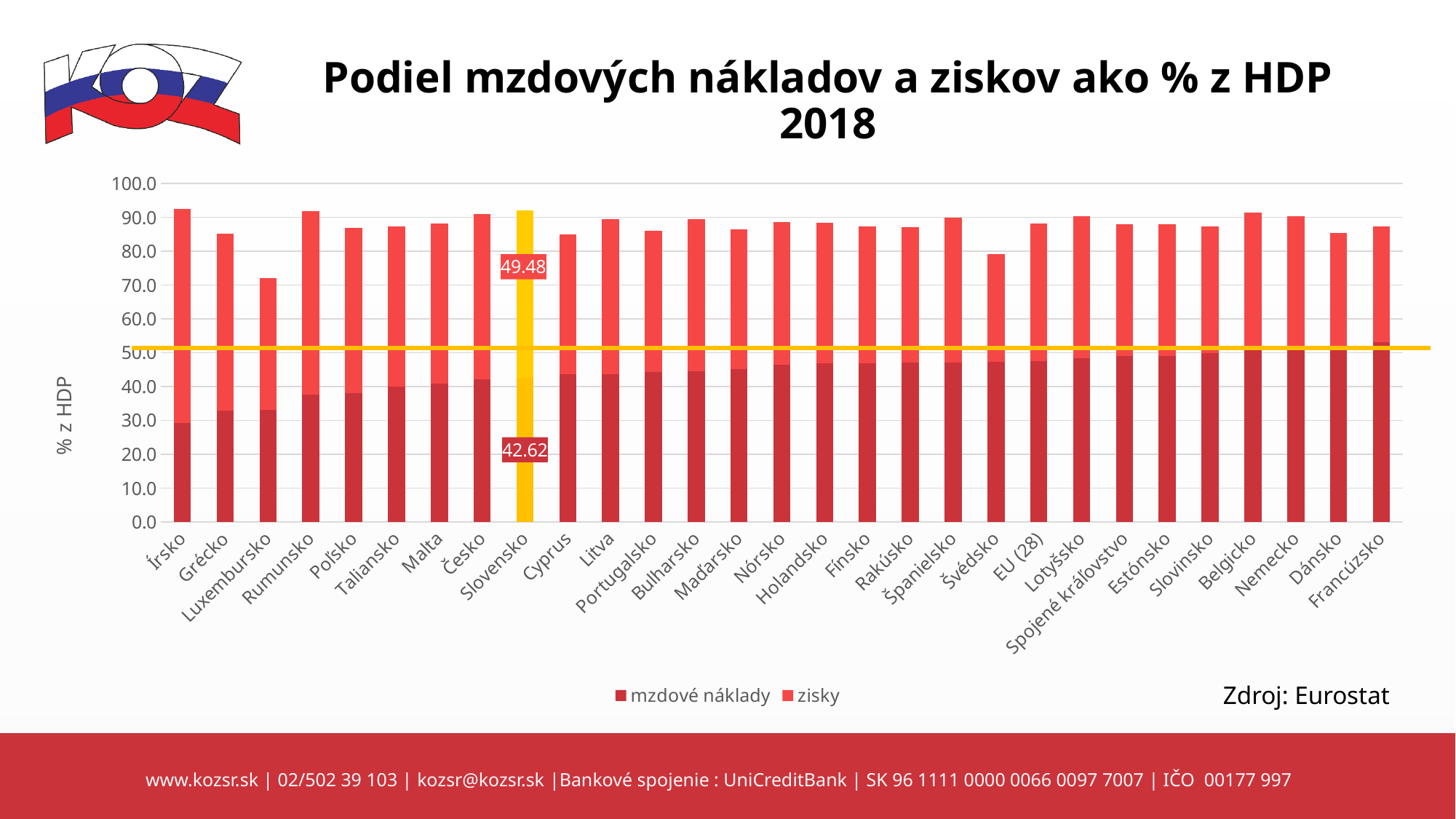
Which is larger, the total stacked bar for Luxembursko or for Rumunsko? Rumunsko What kind of chart is shown on the slide? stacked bar chart Which country has the lowest total stacked bar? Luxembursko Which country has the lowest value for mzdové náklady? Írsko Is the value of mzdové náklady for Francúzsko greater or less than 50? greater What is the value of zisky for Slovensko? 49.48 How many series does the legend list? 2 What is the value of mzdové náklady for Slovensko? 42.62 What is the difference between zisky and mzdové náklady for Slovensko? 6.86 Do the values of mzdové náklady rise or fall from left to right along the x axis? rise What is the total of the stacked bar for Slovensko? 92.10 Is the total stacked bar for Luxembursko greater or less than 80? less